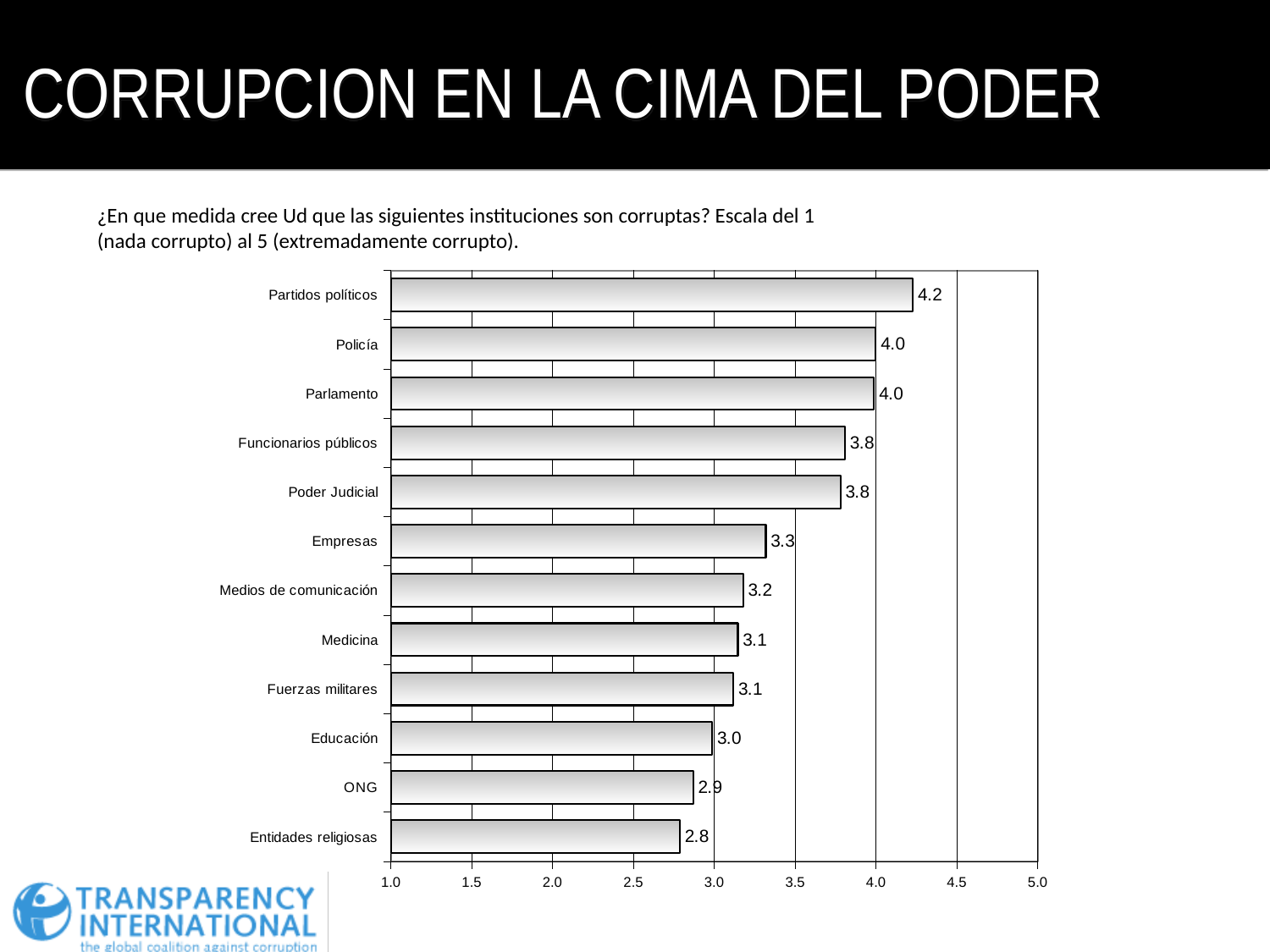
What kind of chart is shown on the slide? Bar chart What is the value for Empresas? 3.3 Which has a larger value, Funcionarios públicos or Empresas? Funcionarios públicos What is the difference between the values for Partidos políticos and Entidades religiosas? 1.4 What is the value for Entidades religiosas? 2.8 What is the value for Medios de comunicación? 3.2 What is the difference between the values for Policía and Educación? 1.0 How many institutions are shown in the chart? 12 What is the maximum value shown on the x axis? 5.0 Which institution has the highest value? Partidos políticos What is the value for Partidos políticos? 4.2 Which institution has the lowest value? Entidades religiosas